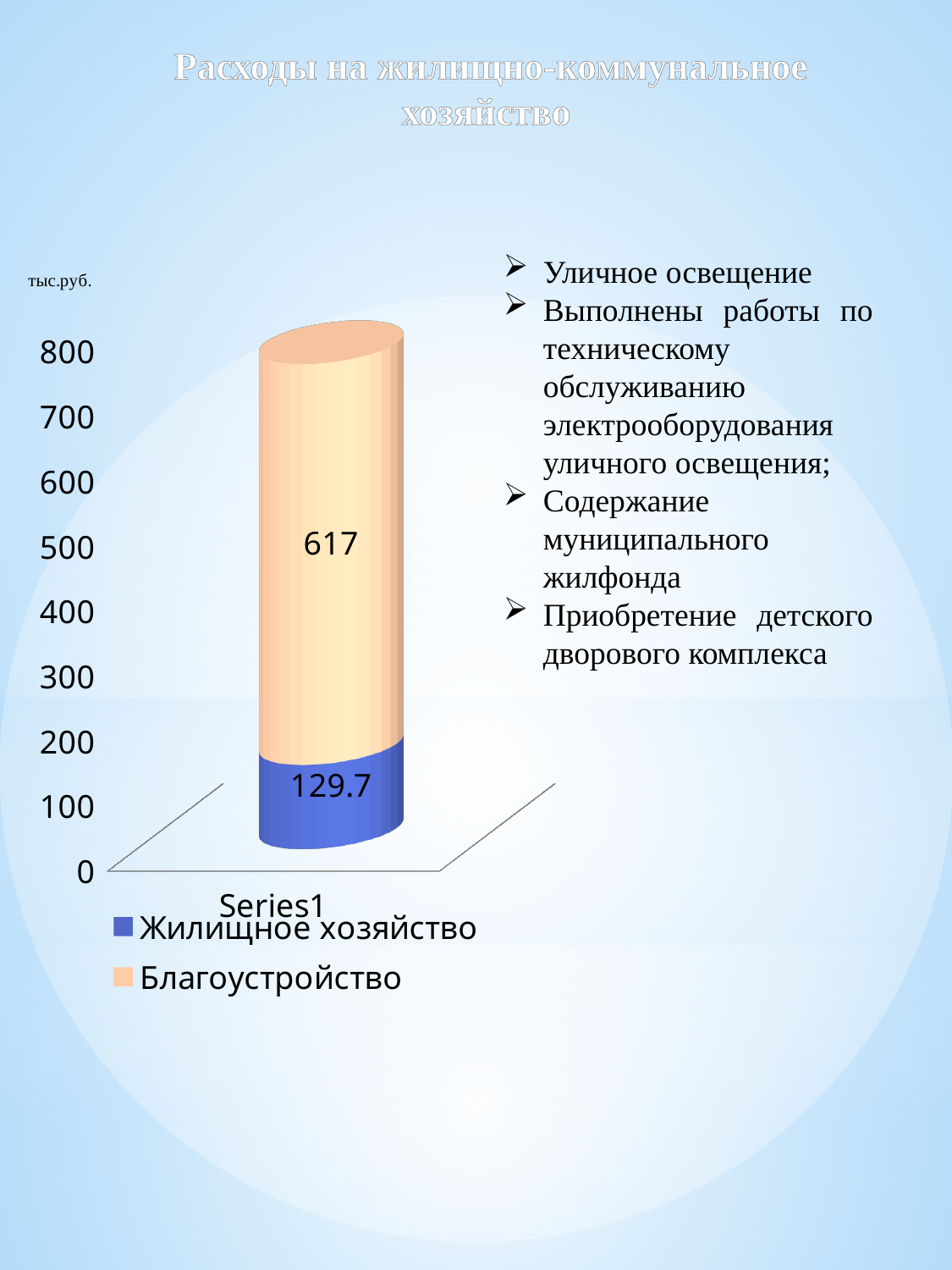
Which series has the largest value in the chart? Благоустройство What kind of chart is shown on the slide? Stacked bar chart What is the difference between the values for Благоустройство and Жилищное хозяйство? 487.3 What unit is indicated above the chart's vertical axis? тыс.руб. What is the total of the stacked bar in the chart? 746.7 What is the value for Благоустройство in the chart? 617 How many series does the legend list? 2 How many categories are shown on the x axis of the chart? 1 What is the title of the slide containing the chart? Расходы на жилищно-коммунальное хозяйство What is the value for Жилищное хозяйство in the chart? 129.7 Which series has the larger value, Жилищное хозяйство or Благоустройство? Благоустройство Which series has the smallest value in the chart? Жилищное хозяйство